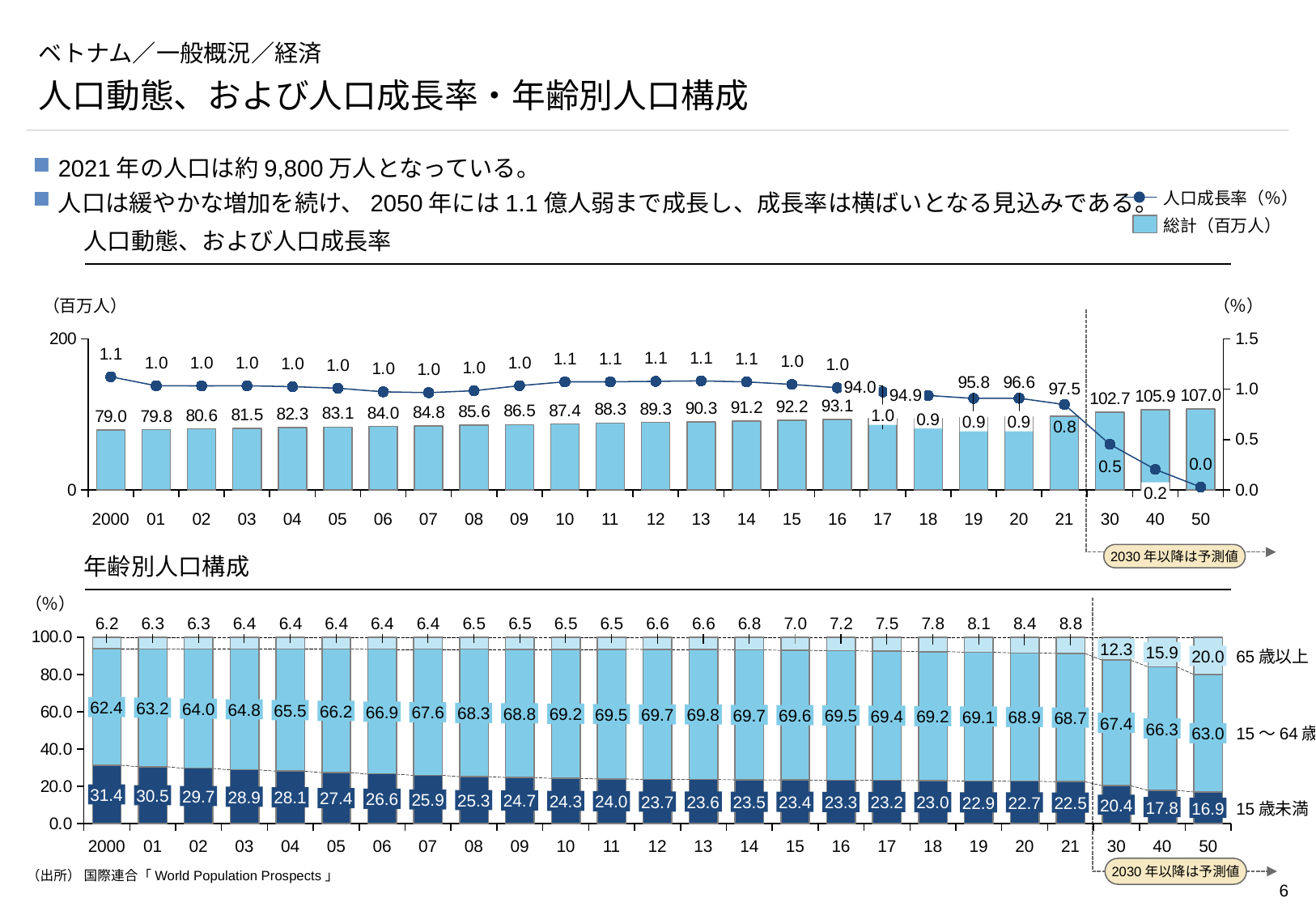
In the top chart (人口動態、および人口成長率), what is the difference between the total population in 2050 and in 2000? 28.0 In the top chart (人口動態、および人口成長率), what is the population growth rate (人口成長率) for 2050? 0.0 In the top chart (人口動態、および人口成長率), does the population growth rate rise or fall from 2021 to 2050? fall In the bottom chart (年齢別人口構成), which year has the lowest value for 15歳未満? 2050 In the top chart (人口動態、および人口成長率), how many years are shown on the x axis? 25 In the bottom chart (年齢別人口構成), is the 15～64歳 share larger in 2013 or in 2000? 2013 How many series does the legend of the top chart (人口動態、および人口成長率) list? 2 What kind of chart is the bottom chart (年齢別人口構成)? stacked bar chart In the bottom chart (年齢別人口構成), what is the value for 15歳未満 in 2000? 31.4 In the bottom chart (年齢別人口構成), what is the value for 65歳以上 in 2050? 20.0 In the top chart (人口動態、および人口成長率), what is the total population (総計) value for 2021? 97.5 In the top chart (人口動態、および人口成長率), which year has the highest total population? 2050